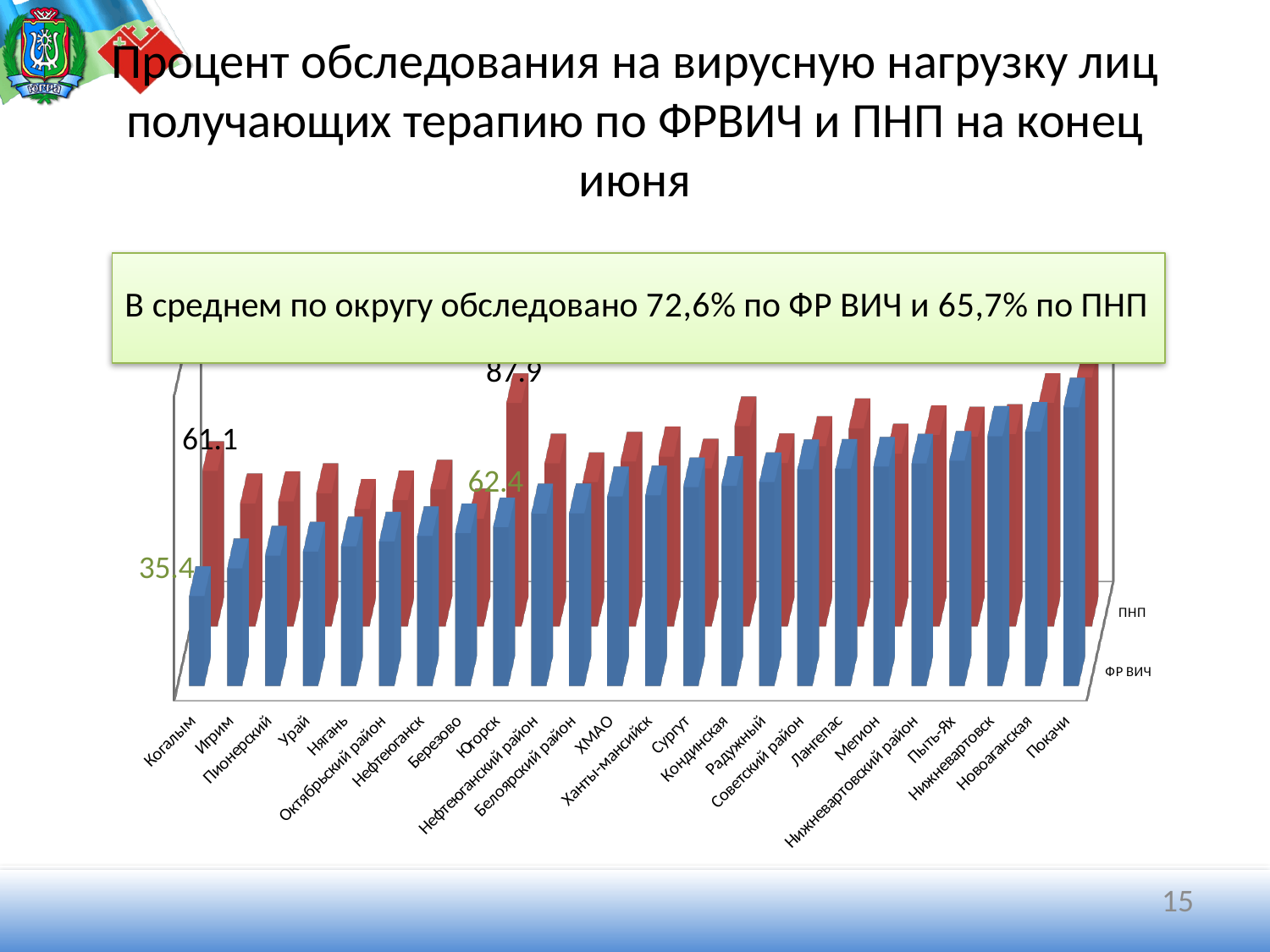
What is the ПНП value for Когалым? 61.1 How many series does the chart show? 2 What is the difference between the ПНП and ФР ВИЧ values for Когалым? 25.7 What is the ФР ВИЧ value for Когалым? 35.4 Which is larger: the ПНП value for Югорск or the ПНП value for Когалым? Югорск What kind of chart is shown on the slide? Bar chart What is the ФР ВИЧ value for Югорск? 62.4 Which category has the highest ФР ВИЧ value? Покачи Do the ФР ВИЧ values generally rise or fall from left to right along the x axis? Rise What is the ПНП value for Югорск? 87.9 Which category has the lowest ФР ВИЧ value? Когалым How many categories are shown on the x axis? 24